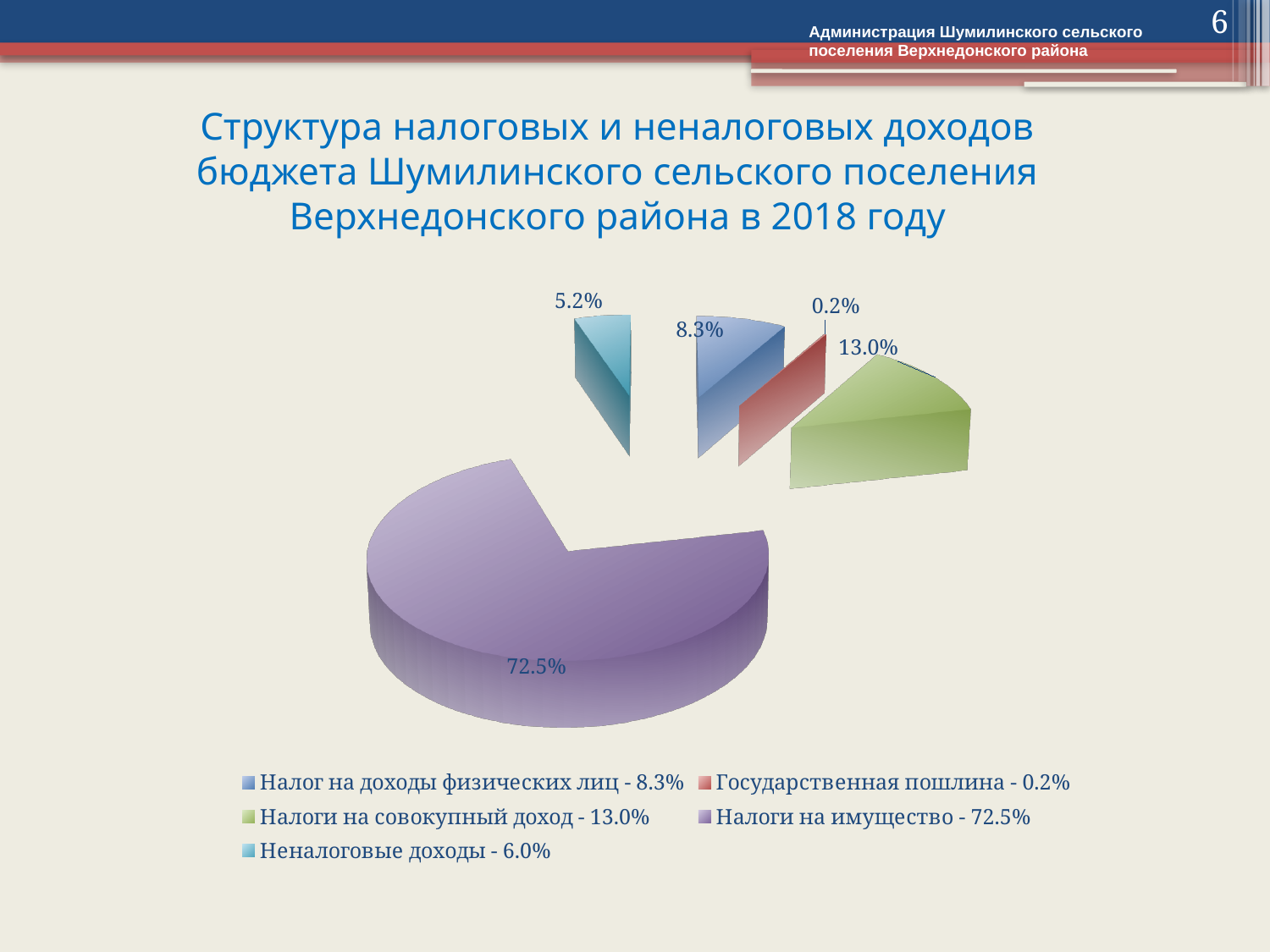
What share of the pie is Государственная пошлина? 0.2% How many entries does the legend list? 5 Which category has the smallest share of the pie? Государственная пошлина Which category has the largest share of the pie? Налоги на имущество By how many percentage points does the share for Налоги на совокупный доход exceed the share for Налог на доходы физических лиц? 4.7 percentage points How many slices does the pie chart have? 5 What share of the pie is Налоги на имущество? 72.5% What share of the pie is Налоги на совокупный доход? 13.0% Which is larger: the share for Налоги на совокупный доход or the share for Налог на доходы физических лиц? Налоги на совокупный доход What kind of chart is shown on the slide? pie chart Which year does the chart title say the data refers to? 2018 What share of the pie is Налог на доходы физических лиц? 8.3%